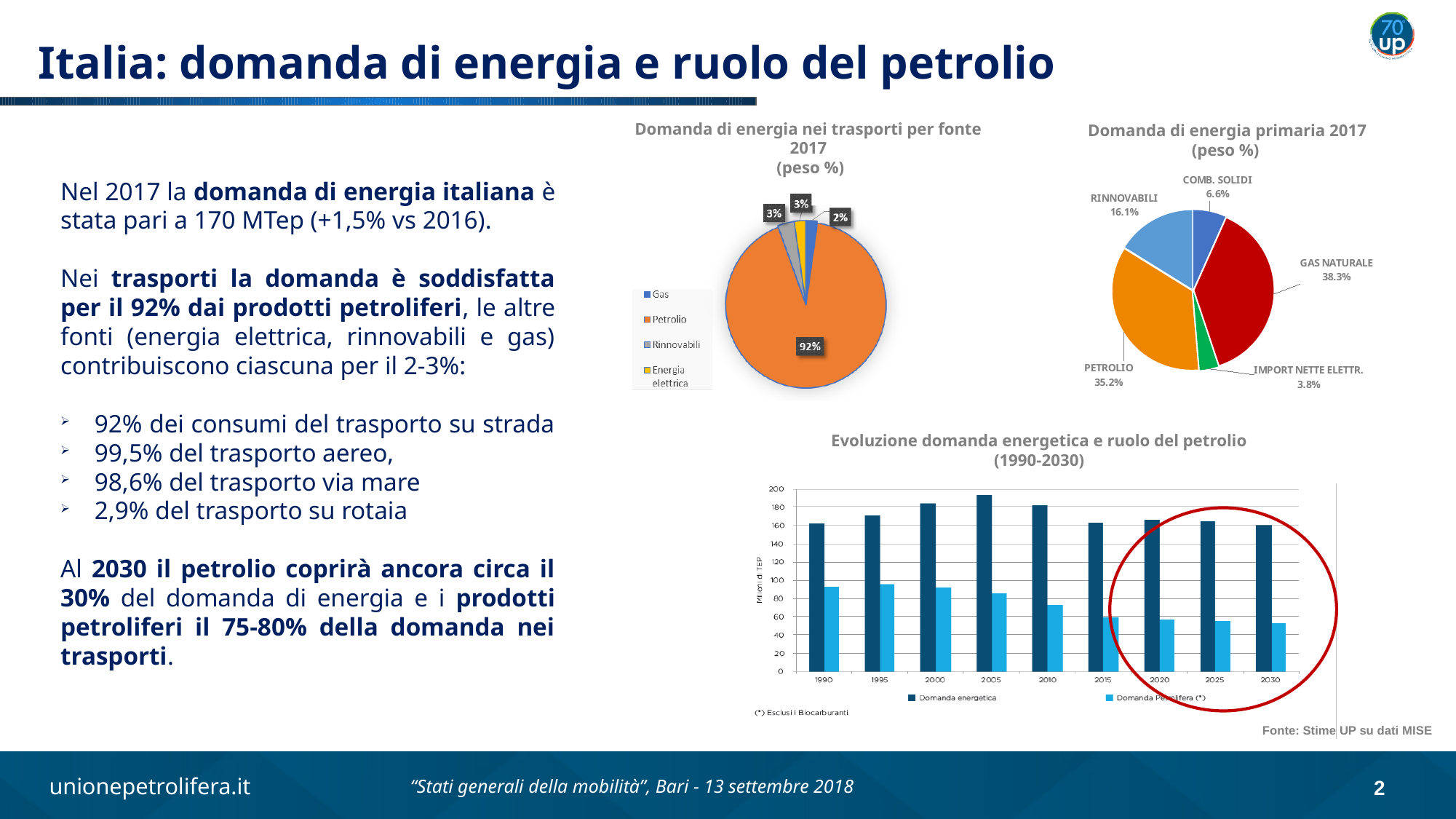
In the pie chart 'Domanda di energia nei trasporti per fonte 2017', how many entries does the legend list? 4 In the chart 'Evoluzione domanda energetica e ruolo del petrolio (1990-2030)', is the Domanda energetica value for 2005 greater or less than 180? greater In the chart 'Evoluzione domanda energetica e ruolo del petrolio (1990-2030)', does the Domanda Petrolifera series rise or fall from 1990 to 2030? fall In the pie chart 'Domanda di energia primaria 2017', how many slices are there? 5 In the pie chart 'Domanda di energia primaria 2017', what is the share for Rinnovabili? 16.1% In the pie chart 'Domanda di energia primaria 2017', what is the share for Gas naturale? 38.3% In the chart 'Evoluzione domanda energetica e ruolo del petrolio (1990-2030)', how many years are shown on the x axis? 9 In the pie chart 'Domanda di energia nei trasporti per fonte 2017', what share is shown for Petrolio? 92% What kind of chart is 'Evoluzione domanda energetica e ruolo del petrolio (1990-2030)'? bar chart In the pie chart 'Domanda di energia primaria 2017', which source has the largest share? Gas naturale In the pie chart 'Domanda di energia primaria 2017', which source has the smallest share? Import nette elettr. In the pie chart 'Domanda di energia primaria 2017', what is the difference between the shares of Gas naturale and Petrolio? 3.1%